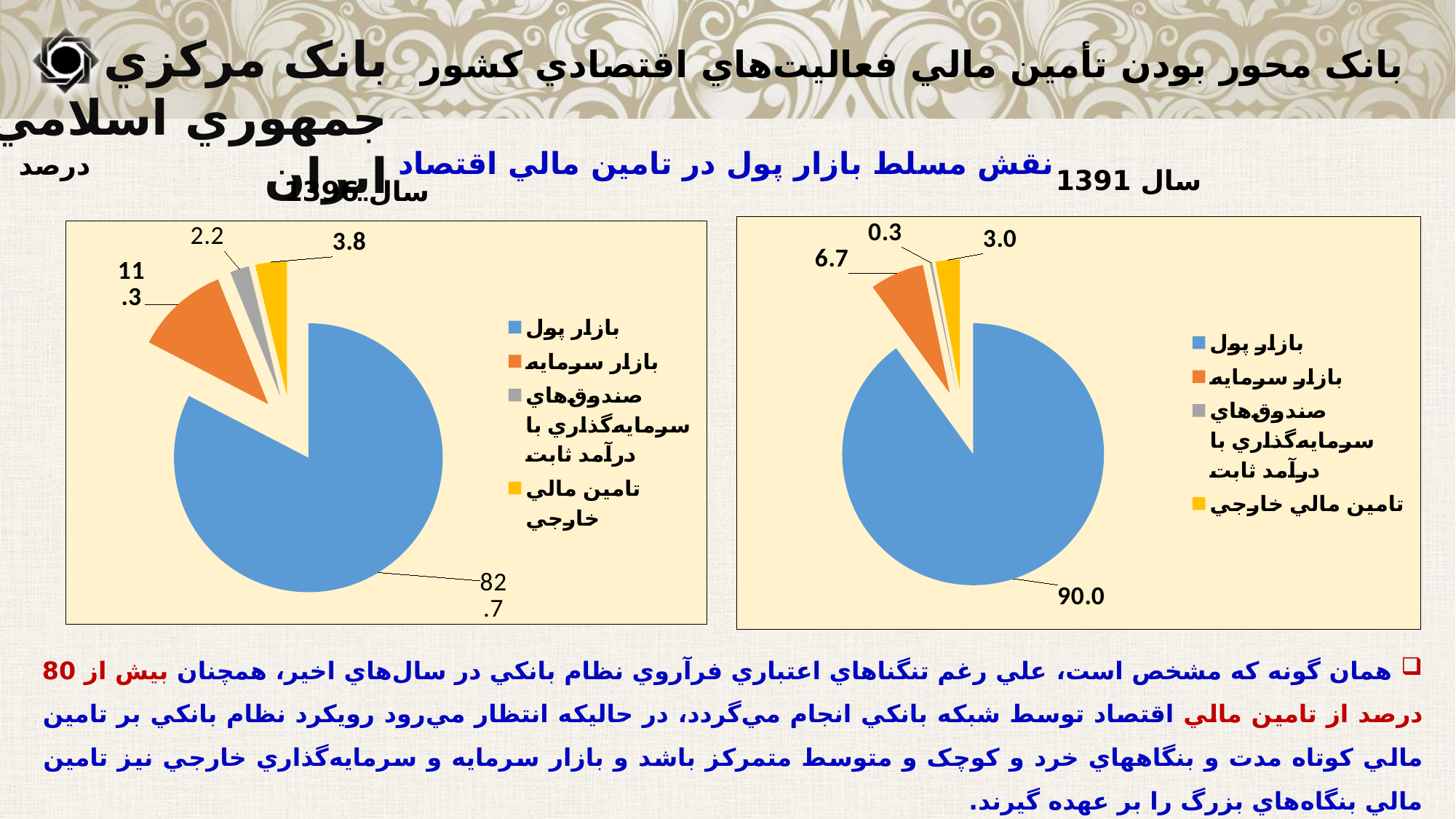
In the left pie chart, what is the value for بازار سرمایه? 11.3 How many slices does the right pie chart (سال 1391) have? 4 In the right pie chart (سال 1391), what is the value for بازار پول? 90.0 In the left pie chart, which is larger: the slice for تامین مالی خارجی or the slice for صندوق‌های سرمایه‌گذاری با درآمد ثابت? تامین مالی خارجی In the right pie chart (سال 1391), what is the value for بازار سرمایه? 6.7 What is the difference between the بازار پول value in the right chart (سال 1391) and the بازار پول value in the left chart? 7.3 What type of chart is used on this slide? Pie chart In the left pie chart, what is the value for تامین مالی خارجی? 3.8 How many entries does the legend of the left pie chart list? 4 In the right pie chart (سال 1391), what colour is the slice for بازار سرمایه? Orange In the right pie chart (سال 1391), which category has the smallest slice? صندوق‌های سرمایه‌گذاری با درآمد ثابت In the left pie chart, which category has the largest slice? بازار پول